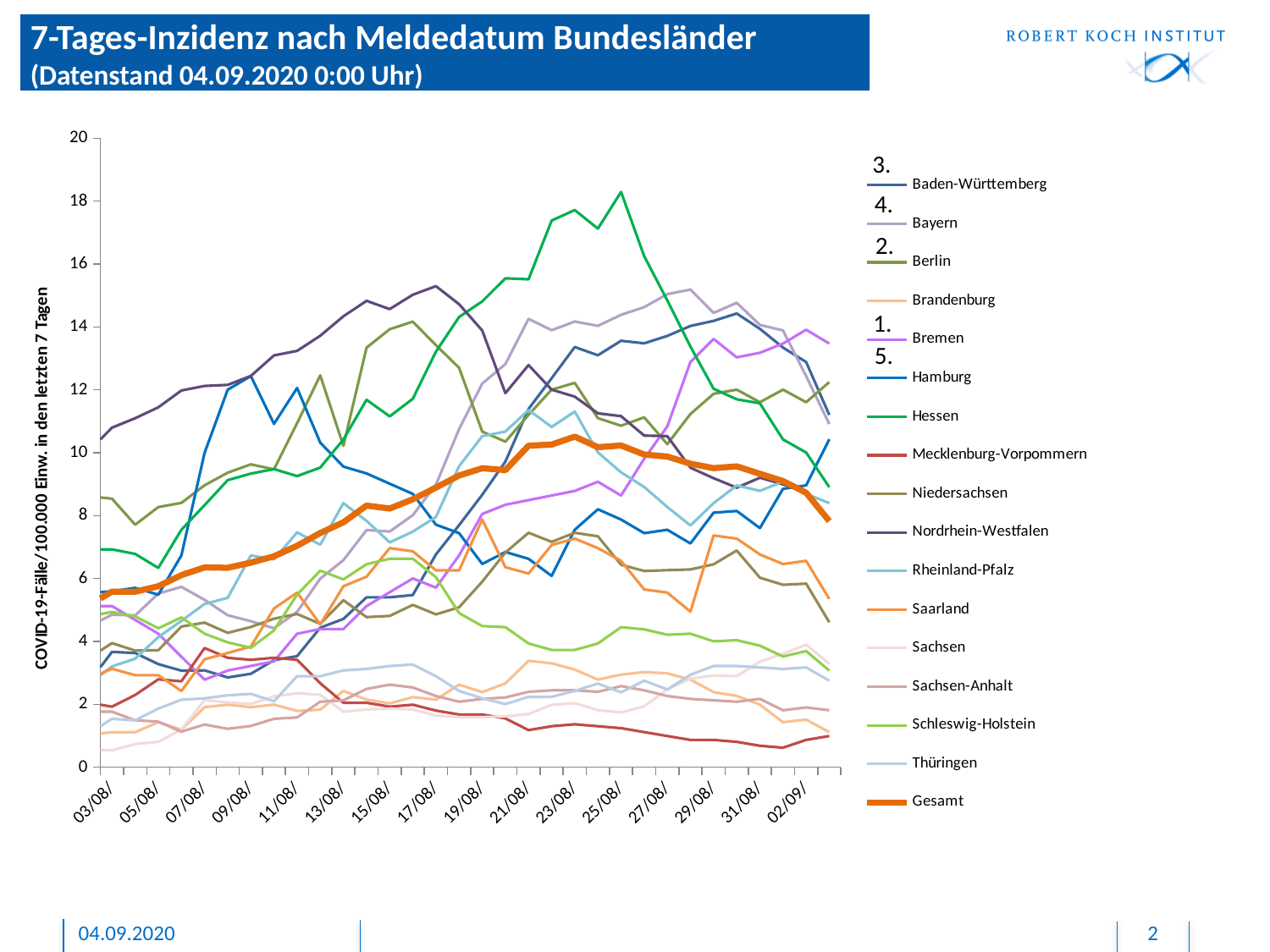
Is the peak value of the Gesamt line greater or less than 12? less Which series reaches the highest value anywhere on the chart? Hessen Is the peak value for Hessen greater or less than 16? greater Which series is drawn as the thick orange line? Gesamt Does the Gesamt line rise or fall between 03/08 and 23/08? rise Is the value for Nordrhein-Westfalen on 17/08 greater or less than 14? greater Which has the higher peak value, Hessen or Bayern? Hessen Does the Hessen line rise or fall between 25/08 and 02/09? fall What is the label of the y axis? COVID-19-Fälle/100.000 Einw. in den letzten 7 Tagen How many series does the legend list? 17 What kind of chart is shown on the slide? line chart